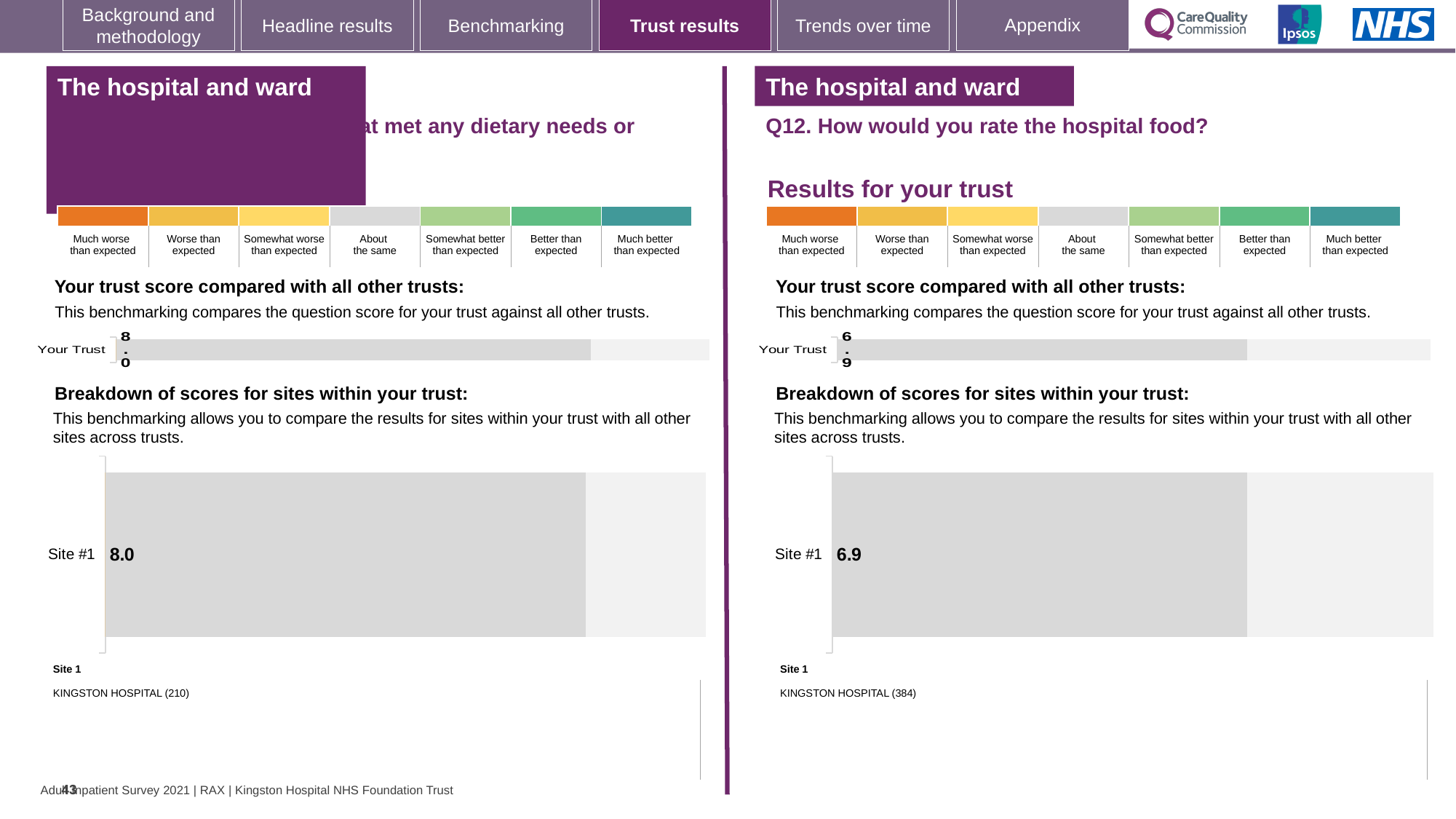
How many sites are plotted in the 'Breakdown of scores for sites within your trust' chart on the right half of the slide (Q12)? 1 How many categories does the colour key above the trust benchmarking chart on the right half of the slide (Q12) show? 7 Which hospital is listed as Site 1 beneath the site breakdown chart on the right half of the slide (Q12)? KINGSTON HOSPITAL (384) In the 'Breakdown of scores for sites within your trust' chart on the right half of the slide (Q12), what is the score for Site #1? 6.9 How many sites are plotted in the 'Breakdown of scores for sites within your trust' chart on the left half of the slide? 1 On the right half of the slide (Q12, hospital food), what is the 'Your Trust' score shown in the trust benchmarking chart? 6.9 What type of chart is used to show the Site #1 score on the right half of the slide (Q12)? Bar chart On the left half of the slide, what is the 'Your Trust' score shown in the trust benchmarking chart? 8.0 Which is larger: the Site #1 score in the left-hand site breakdown chart or the Site #1 score in the right-hand (Q12) site breakdown chart? The left-hand chart (8.0) In the 'Breakdown of scores for sites within your trust' chart on the left half of the slide, what is the score for Site #1? 8.0 What type of chart is used to show the 'Your Trust' score on the left half of the slide? Bar chart What is the difference between the 'Your Trust' score on the left half of the slide and the 'Your Trust' score on the right half (Q12)? 1.1